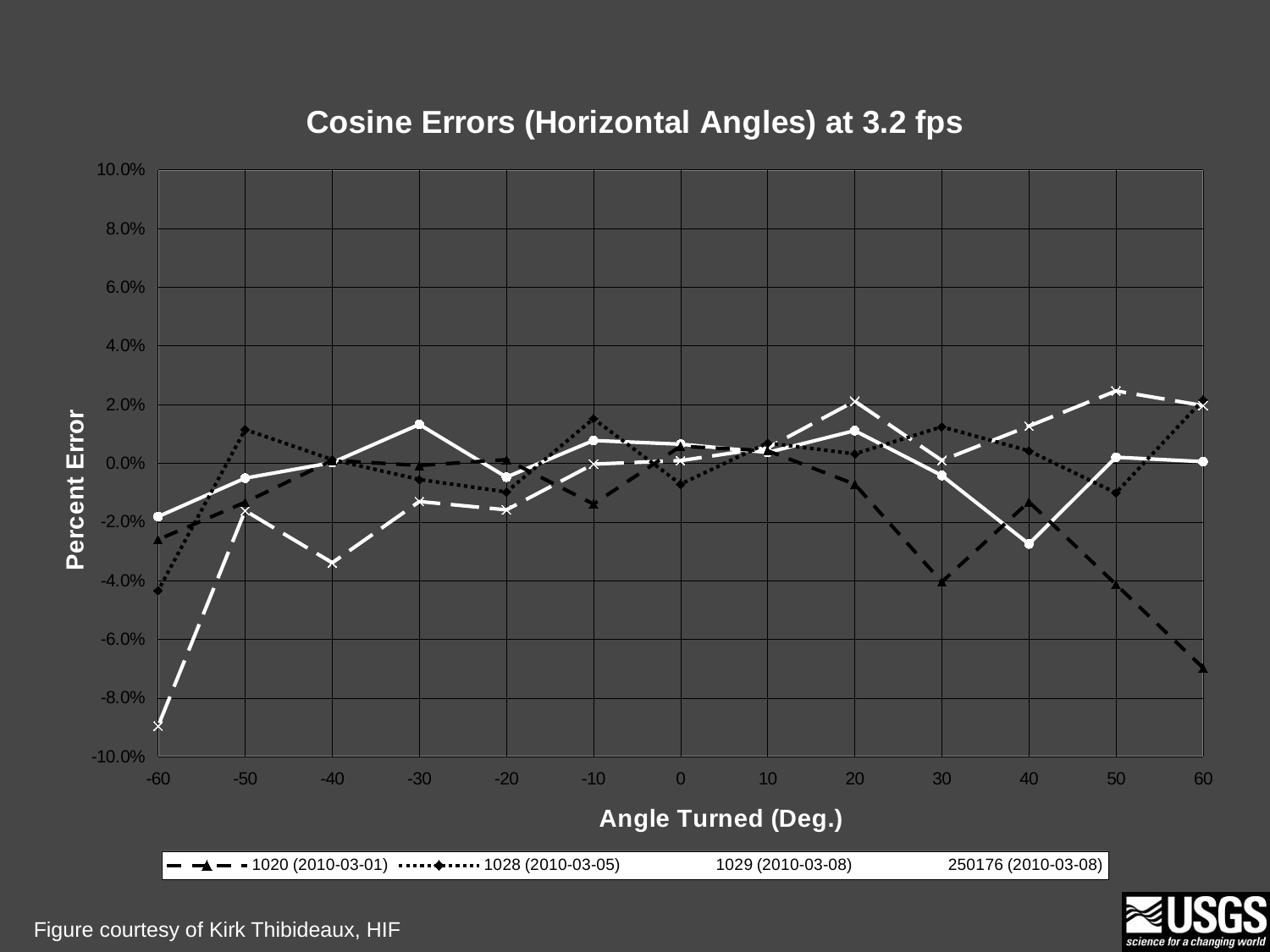
What kind of chart is shown on the slide? line chart Is the value for series 1029 (2010-03-08) at 40 degrees greater or less than -2.0%? less What is the label of the y axis? Percent Error How many angle values are marked along the x axis? 13 Does the value for series 1020 (2010-03-01) rise or fall from 40 degrees to 60 degrees? fall Is the value for series 250176 (2010-03-08) at 50 degrees greater or less than 2.0%? greater Is the value for series 1020 (2010-03-01) at 60 degrees greater or less than -6.0%? less Which series has the lowest value at -60 degrees? 250176 (2010-03-08) What is the title of the chart? Cosine Errors (Horizontal Angles) at 3.2 fps How many series does the legend list? 4 Which series has the lowest value at 60 degrees? 1020 (2010-03-01)